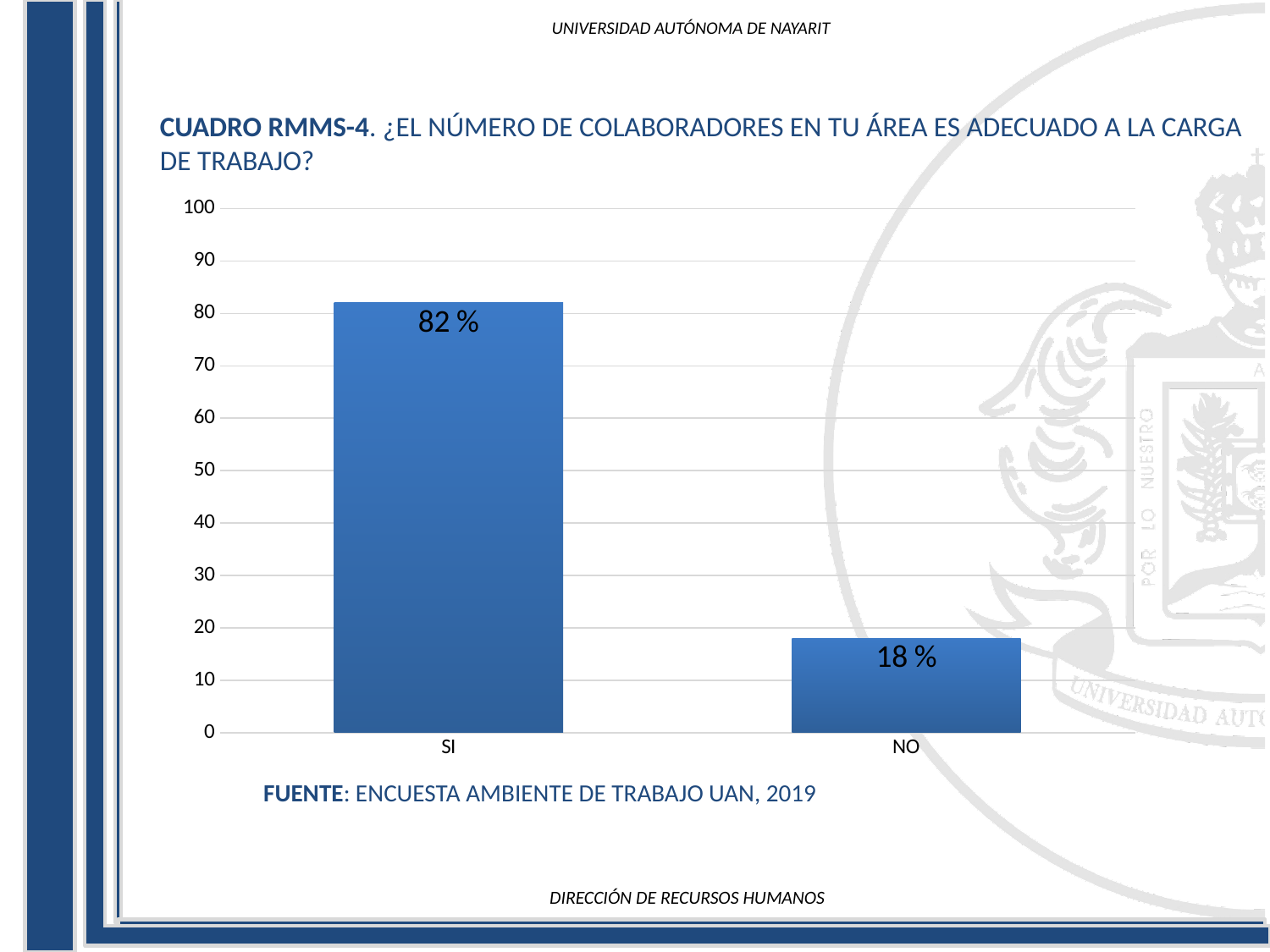
How many categories are shown on the x axis? 2 What source is cited below the chart? ENCUESTA AMBIENTE DE TRABAJO UAN, 2019 What is the value for NO? 18 % Which category has the highest value? SI What is the difference between the values for SI and NO? 64 % What kind of chart is shown on the slide? bar chart What is the maximum value shown on the y axis? 100 Is the value for NO greater or less than 20? less Which category has the lowest value? NO What is the value for SI? 82 % Is the value for SI greater or less than 80? greater Which is larger, the value for SI or the value for NO? SI